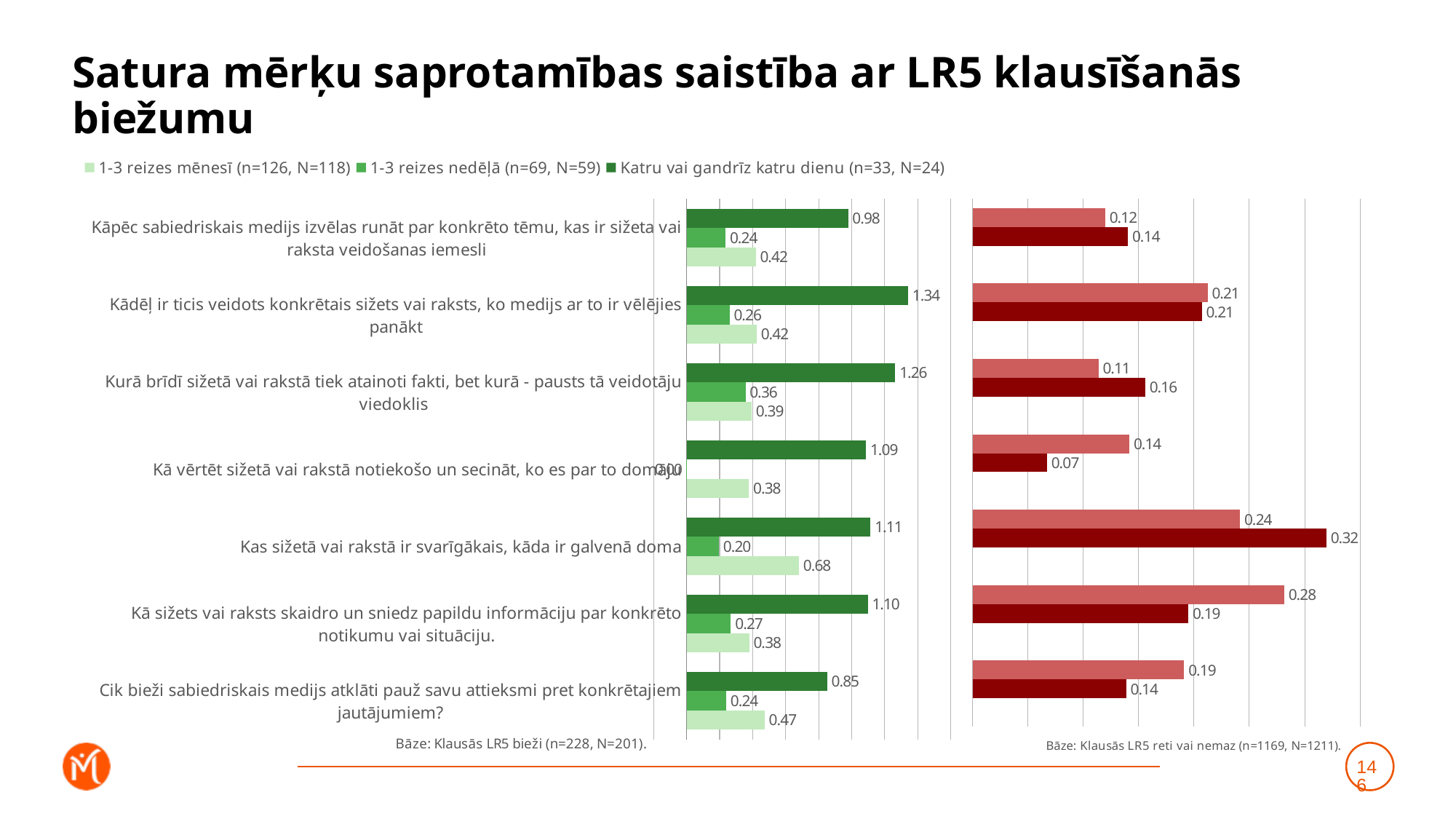
In the left chart (Bāze: Klausās LR5 bieži), for the category 'Kāpēc sabiedriskais medijs izvēlas runāt par konkrēto tēmu', which series has the larger value: '1-3 reizes nedēļā' or '1-3 reizes mēnesī'? 1-3 reizes mēnesī How many categories are shown in the left chart (Bāze: Klausās LR5 bieži)? 7 How many series does the legend of the left chart list? 3 In the left chart (Bāze: Klausās LR5 bieži), what is the value for 'Katru vai gandrīz katru dienu' for the category 'Kādēļ ir ticis veidots konkrētais sižets vai raksts, ko medijs ar to ir vēlējies panākt'? 1.34 In the left chart (Bāze: Klausās LR5 bieži), what is the difference between the 'Katru vai gandrīz katru dienu' value and the '1-3 reizes mēnesī' value for 'Kas sižetā vai rakstā ir svarīgākais, kāda ir galvenā doma'? 0.43 In the right chart (Bāze: Klausās LR5 reti vai nemaz), which category has the highest value of any bar? Kas sižetā vai rakstā ir svarīgākais, kāda ir galvenā doma In the left chart (Bāze: Klausās LR5 bieži), what is the value for '1-3 reizes mēnesī' for the category 'Kas sižetā vai rakstā ir svarīgākais, kāda ir galvenā doma'? 0.68 In the left chart (Bāze: Klausās LR5 bieži), which category has the lowest value for the series 'Katru vai gandrīz katru dienu'? Cik bieži sabiedriskais medijs atklāti pauž savu attieksmi pret konkrētajiem jautājumiem? What base note is printed under the left chart? Bāze: Klausās LR5 bieži (n=228, N=201). In the left chart (Bāze: Klausās LR5 bieži), what is the value for '1-3 reizes nedēļā' for the category 'Kā sižets vai raksts skaidro un sniedz papildu informāciju par konkrēto notikumu vai situāciju.'? 0.27 In the left chart (Bāze: Klausās LR5 bieži), which category has the highest value for the series 'Katru vai gandrīz katru dienu'? Kādēļ ir ticis veidots konkrētais sižets vai raksts, ko medijs ar to ir vēlējies panākt What type of chart is the left chart (Bāze: Klausās LR5 bieži)? Bar chart